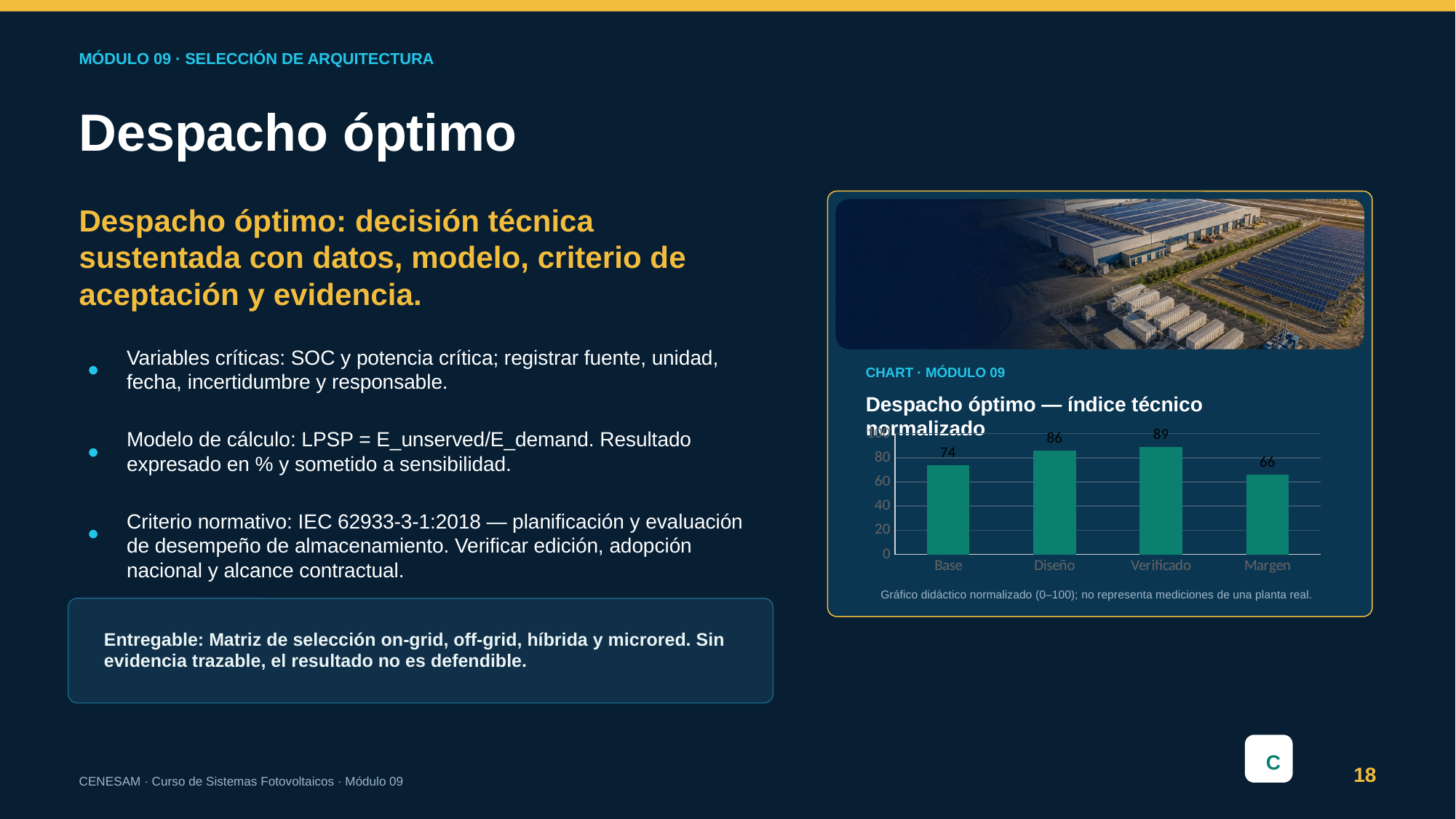
Which is larger, the value for Base or the value for Margen? Base What is the difference between the values for Diseño and Base? 12 What is the value for Base? 74 What is the value for Verificado? 89 How many categories are shown on the x axis? 4 What is the difference between the values for Verificado and Margen? 23 What kind of chart is shown on the slide? Bar chart What is the value for Diseño? 86 What is the title of the chart? Despacho óptimo — índice técnico normalizado What is the value for Margen? 66 Which category has the lowest value? Margen Which category has the highest value? Verificado